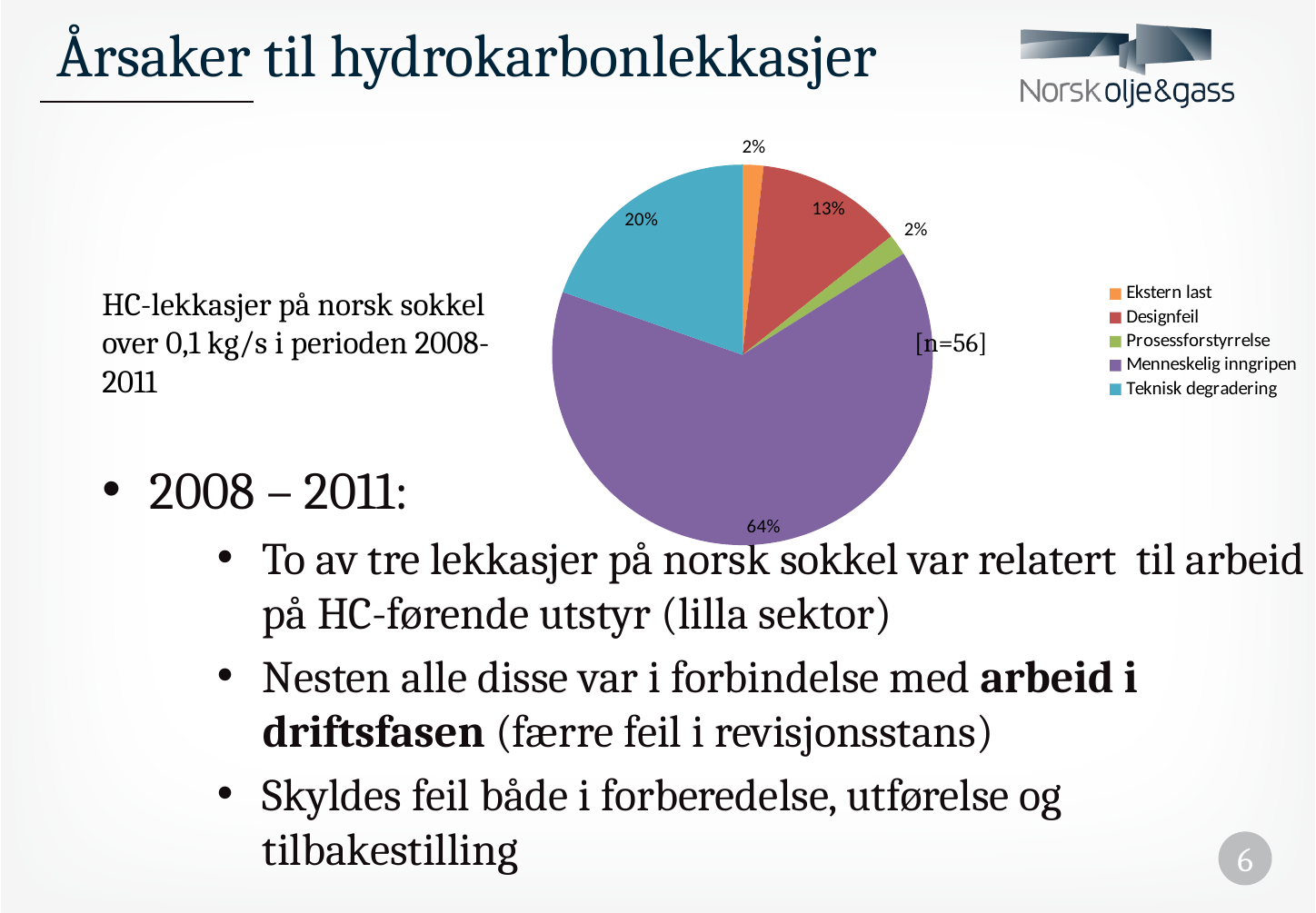
What share of the pie does Menneskelig inngripen account for? 64% How many categories does the legend list? 5 Which is larger, the slice for Designfeil or the slice for Teknisk degradering? Teknisk degradering What sample size is noted next to the pie chart? [n=56] What kind of chart is shown on the slide? pie chart What share of the pie does Prosessforstyrrelse account for? 2% Which colour represents Menneskelig inngripen in the pie chart? purple What share of the pie does Ekstern last account for? 2% Which category has the largest slice of the pie? Menneskelig inngripen What is the difference in percentage points between Menneskelig inngripen and Teknisk degradering? 44 percentage points